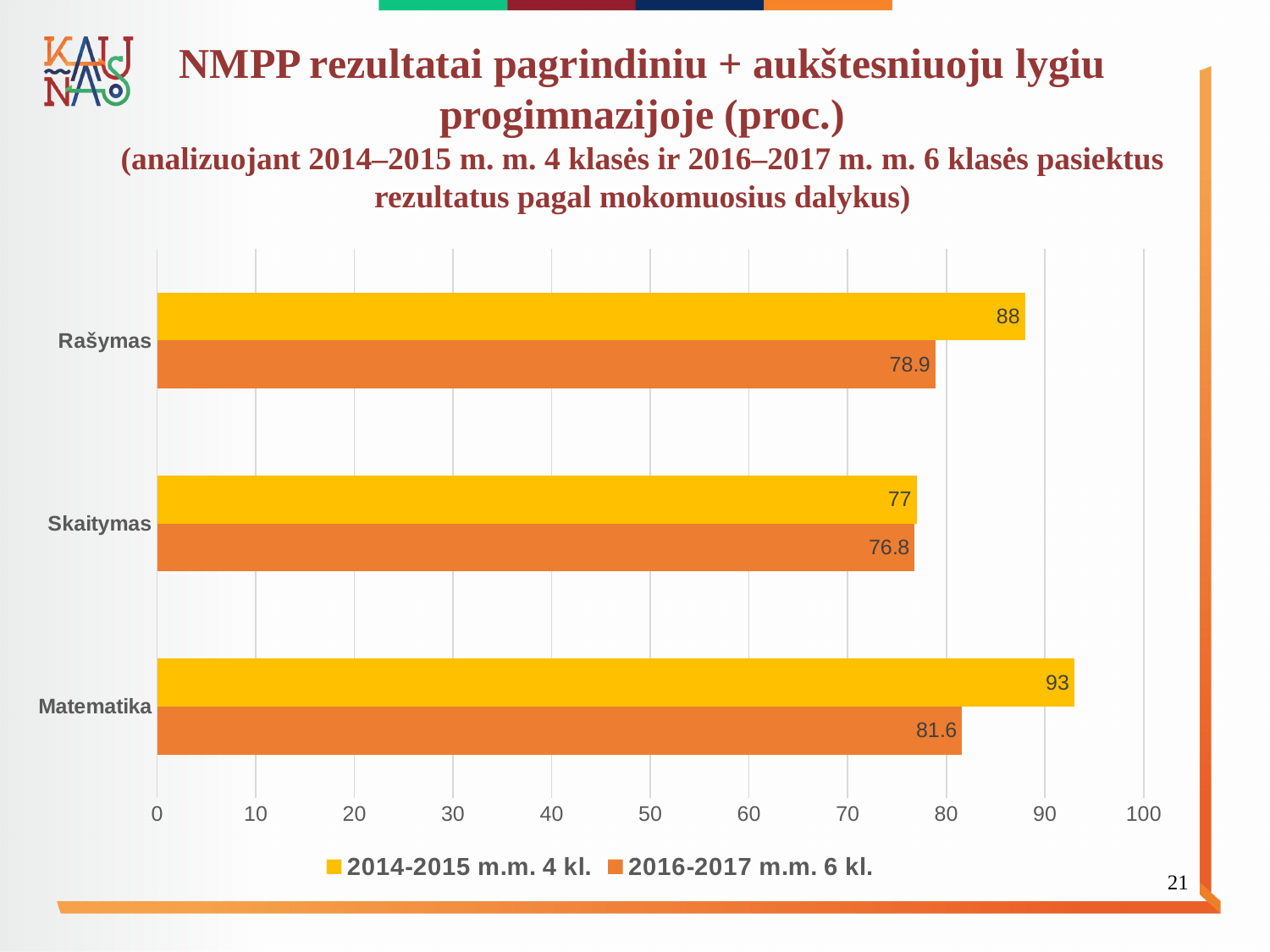
What is the value for Rašymas in the 2014-2015 m.m. 4 kl. series? 88 What is the difference between the 2014-2015 m.m. 4 kl. and 2016-2017 m.m. 6 kl. values for Matematika? 11.4 What kind of chart is shown on the slide? Bar chart How many categories are shown on the chart? 3 Which category has the lowest value in the 2016-2017 m.m. 6 kl. series? Skaitymas What is the value for Matematika in the 2016-2017 m.m. 6 kl. series? 81.6 Which is larger: the 2014-2015 m.m. 4 kl. value for Rašymas or the 2014-2015 m.m. 4 kl. value for Skaitymas? Rašymas Which category has the highest value in the 2014-2015 m.m. 4 kl. series? Matematika How many series does the legend list? 2 What is the value for Skaitymas in the 2016-2017 m.m. 6 kl. series? 76.8 What is the difference between the 2014-2015 m.m. 4 kl. and 2016-2017 m.m. 6 kl. values for Rašymas? 9.1 Which colour represents the 2016-2017 m.m. 6 kl. series? Orange